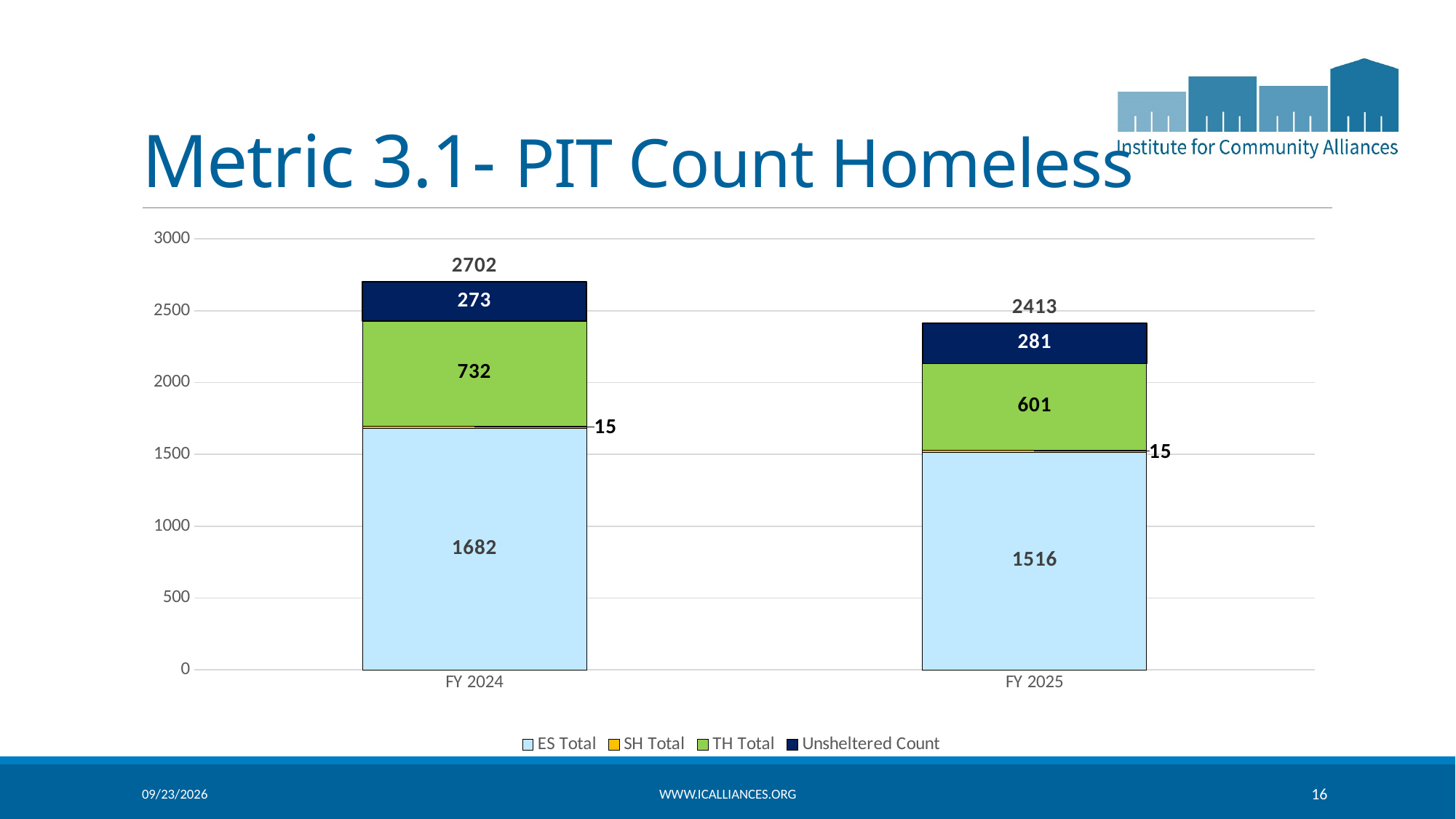
What is the total of the stacked bar for FY 2024? 2702 What is the ES Total value for FY 2024? 1682 What is the Unsheltered Count for FY 2025? 281 What is the SH Total value for FY 2024? 15 Does the total PIT count rise or fall from FY 2024 to FY 2025? Fall What is the TH Total value for FY 2025? 601 What is the difference between the ES Total for FY 2024 and FY 2025? 166 Is the Unsheltered Count larger in FY 2024 or FY 2025? FY 2025 Which fiscal year has the higher total PIT count? FY 2024 What is the total of the stacked bar for FY 2025? 2413 How many series does the legend list? 4 What kind of chart is shown on the slide? Stacked bar chart